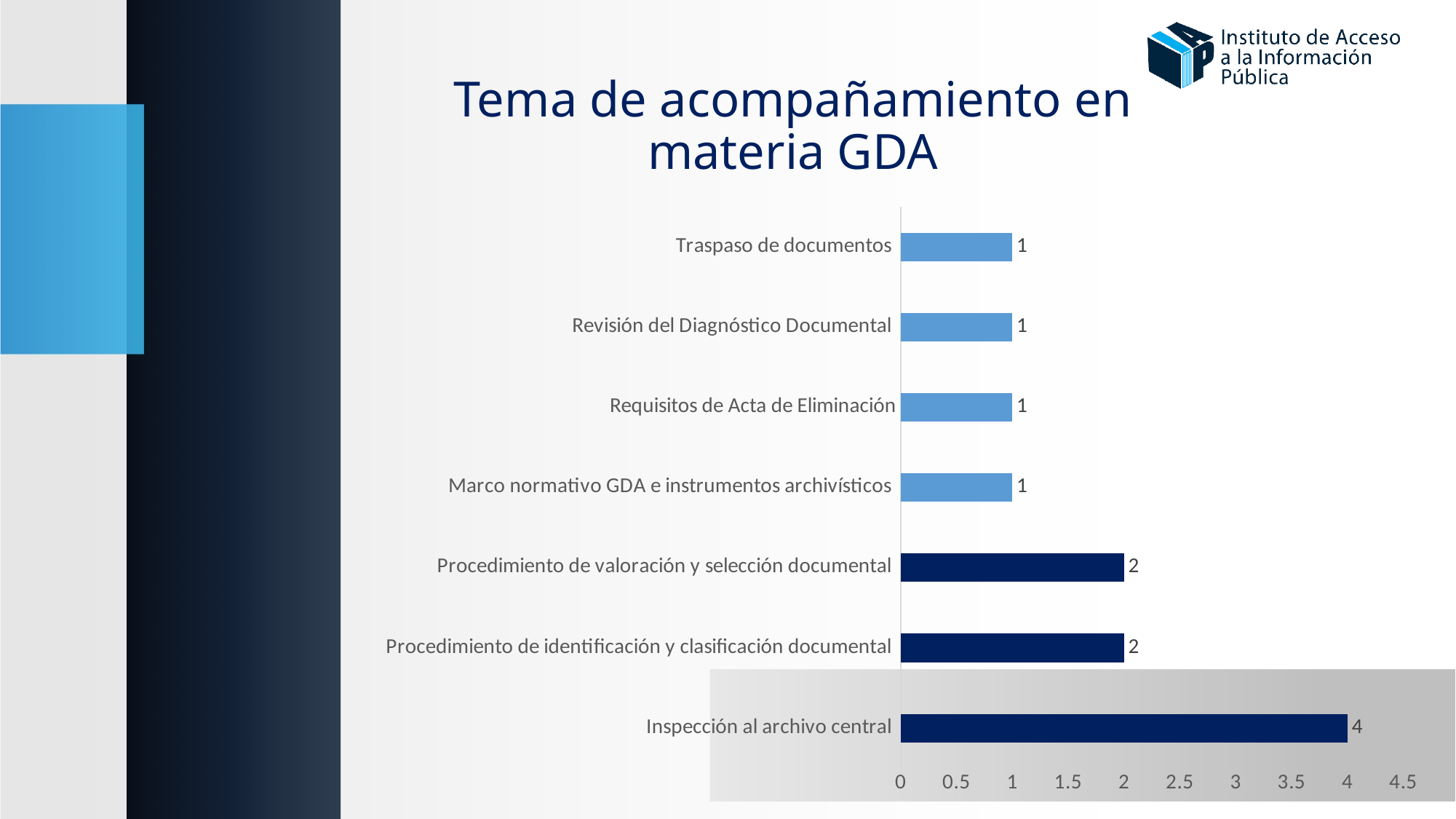
What is the highest value shown on the x axis? 4.5 What is the value for Inspección al archivo central? 4 What is the title of the slide? Tema de acompañamiento en materia GDA Which category has the highest value? Inspección al archivo central What kind of chart is shown on the slide? Bar chart What is the value for Traspaso de documentos? 1 What is the value for Procedimiento de identificación y clasificación documental? 2 What is the difference between the values for Inspección al archivo central and Procedimiento de valoración y selección documental? 2 How many categories are shown in the chart? 7 What is the value for Procedimiento de valoración y selección documental? 2 Is the value for Inspección al archivo central greater or less than 3? greater Which is larger: the value for Inspección al archivo central or the value for Marco normativo GDA e instrumentos archivísticos? Inspección al archivo central